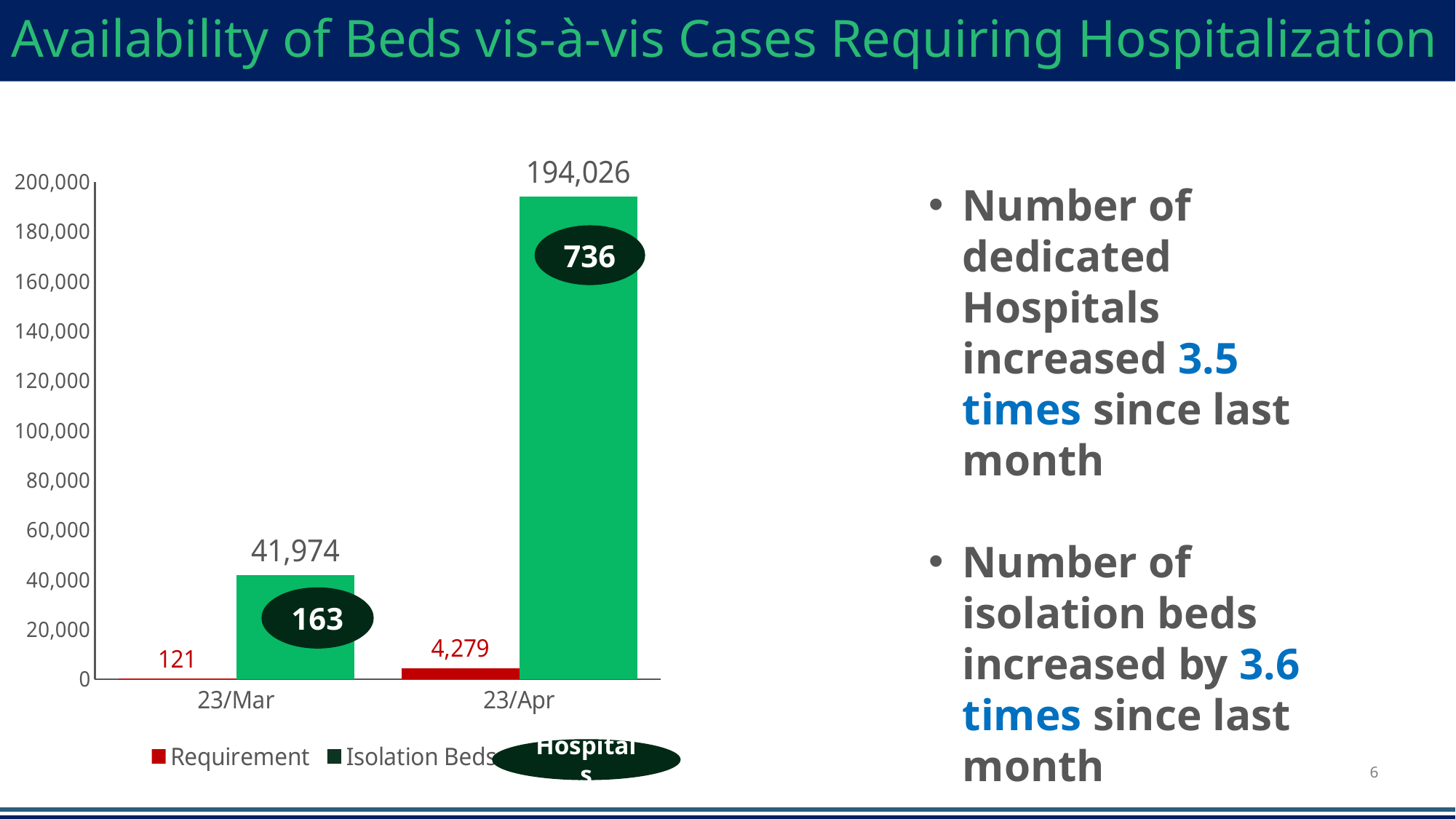
By how much did Isolation Beds increase from 23/Mar to 23/Apr? 152,052 Which date has the higher number of Isolation Beds? 23/Apr How many series does the legend list? 2 Is the Isolation Beds value on 23/Apr greater or less than 180,000? greater What is the value of Isolation Beds on 23/Mar? 41,974 What is the value of Isolation Beds on 23/Apr? 194,026 What type of chart is shown on the slide? Bar chart What is the Requirement value on 23/Apr? 4,279 What is the Requirement value on 23/Mar? 121 Which date has the lower Requirement value? 23/Mar What colour are the Requirement bars? Red What is the difference between Isolation Beds and Requirement on 23/Apr? 189,747